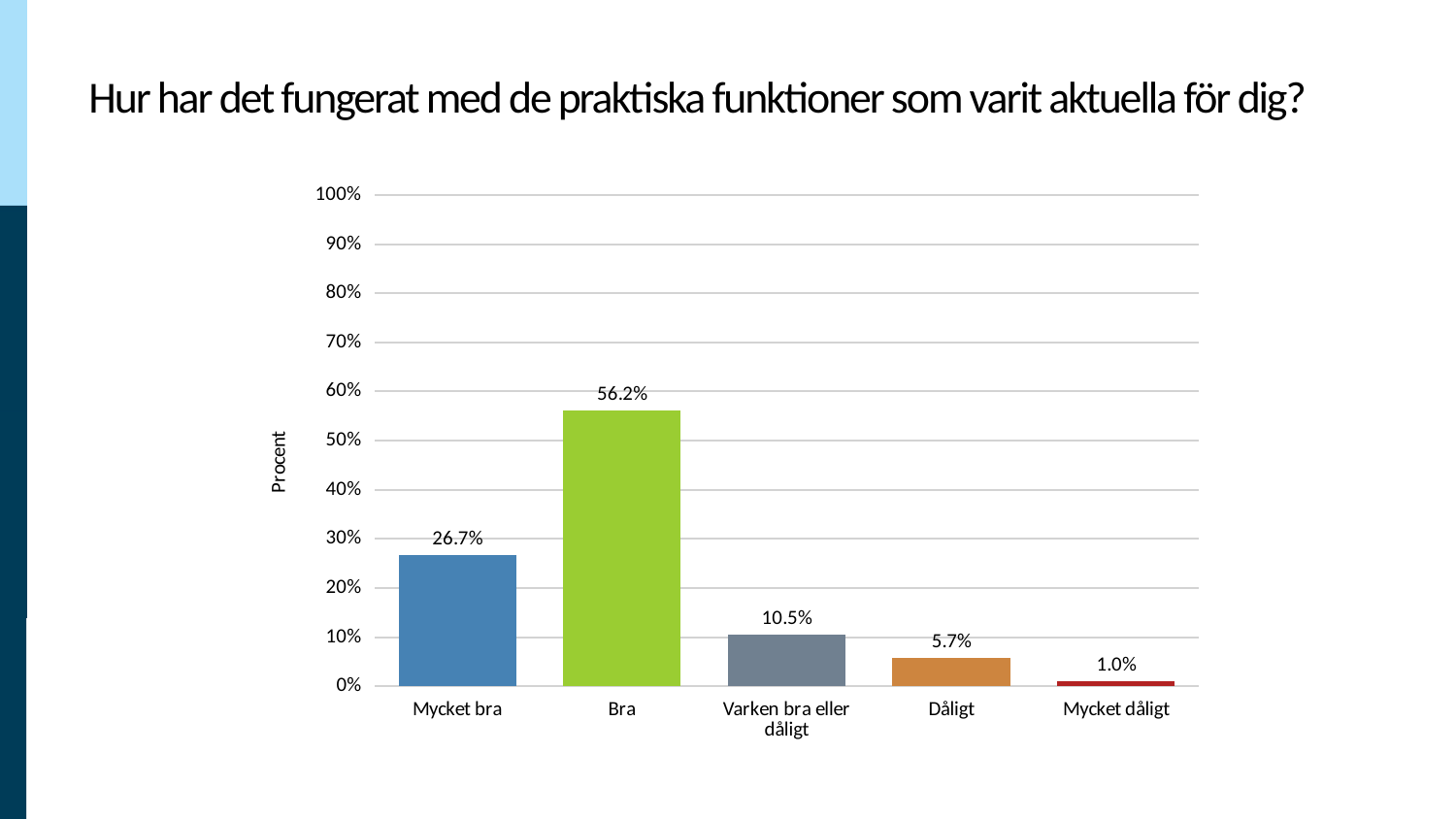
Which category has the highest value? Bra What is the difference between the values for "Bra" and "Mycket bra"? 29.5% What is the value for "Varken bra eller dåligt"? 10.5% What is the value for "Mycket dåligt"? 1.0% How many categories are shown on the x axis? 5 What kind of chart is shown on the slide? bar chart What is the value for "Mycket bra"? 26.7% What is the label of the vertical axis? Procent Which category has the lowest value? Mycket dåligt Is the value for "Bra" greater or less than 50%? greater Which is larger, the value for "Dåligt" or the value for "Varken bra eller dåligt"? Varken bra eller dåligt What is the value for "Bra"? 56.2%